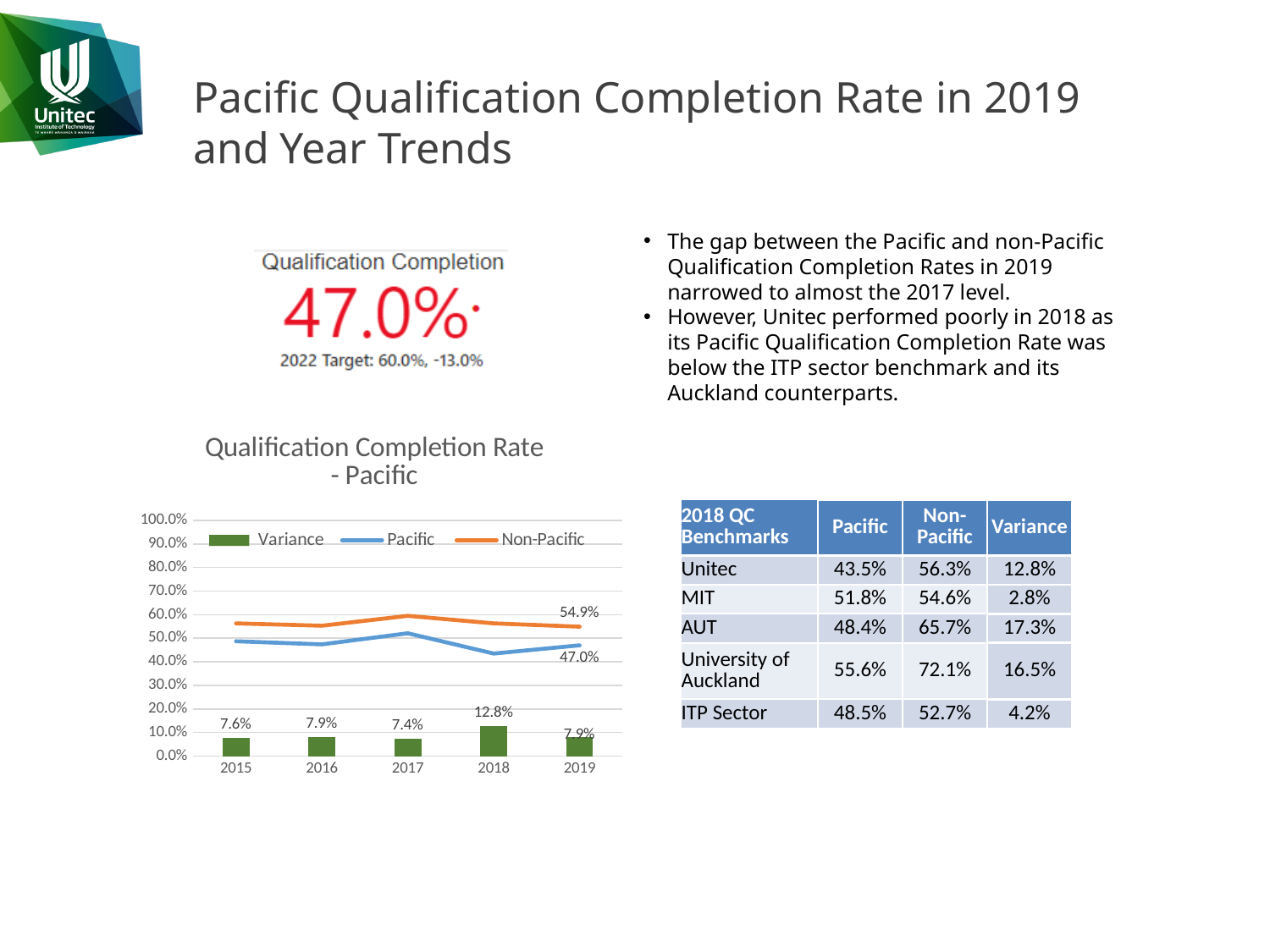
In the 'Qualification Completion Rate - Pacific' chart, which year has the lowest Variance? 2017 In the 'Qualification Completion Rate - Pacific' chart, what is the Non-Pacific value for 2019? 54.9% In the 'Qualification Completion Rate - Pacific' chart, is the Pacific value for 2018 greater or less than 50.0%? less How many years are shown on the x axis of the 'Qualification Completion Rate - Pacific' chart? 5 In the 'Qualification Completion Rate - Pacific' chart, what is the difference between the Non-Pacific and Pacific values in 2019? 7.9% In the 'Qualification Completion Rate - Pacific' chart, is the Non-Pacific value for 2017 greater or less than 50.0%? greater In the 'Qualification Completion Rate - Pacific' chart, what is the Variance value for 2018? 12.8% In the 'Qualification Completion Rate - Pacific' chart, what is the Pacific value for 2019? 47.0% In the 'Qualification Completion Rate - Pacific' chart, what is the Variance value for 2015? 7.6% How many series does the legend of the 'Qualification Completion Rate - Pacific' chart list? 3 In the 'Qualification Completion Rate - Pacific' chart, which series is drawn as bars rather than lines? Variance In the 'Qualification Completion Rate - Pacific' chart, which year has the highest Variance? 2018